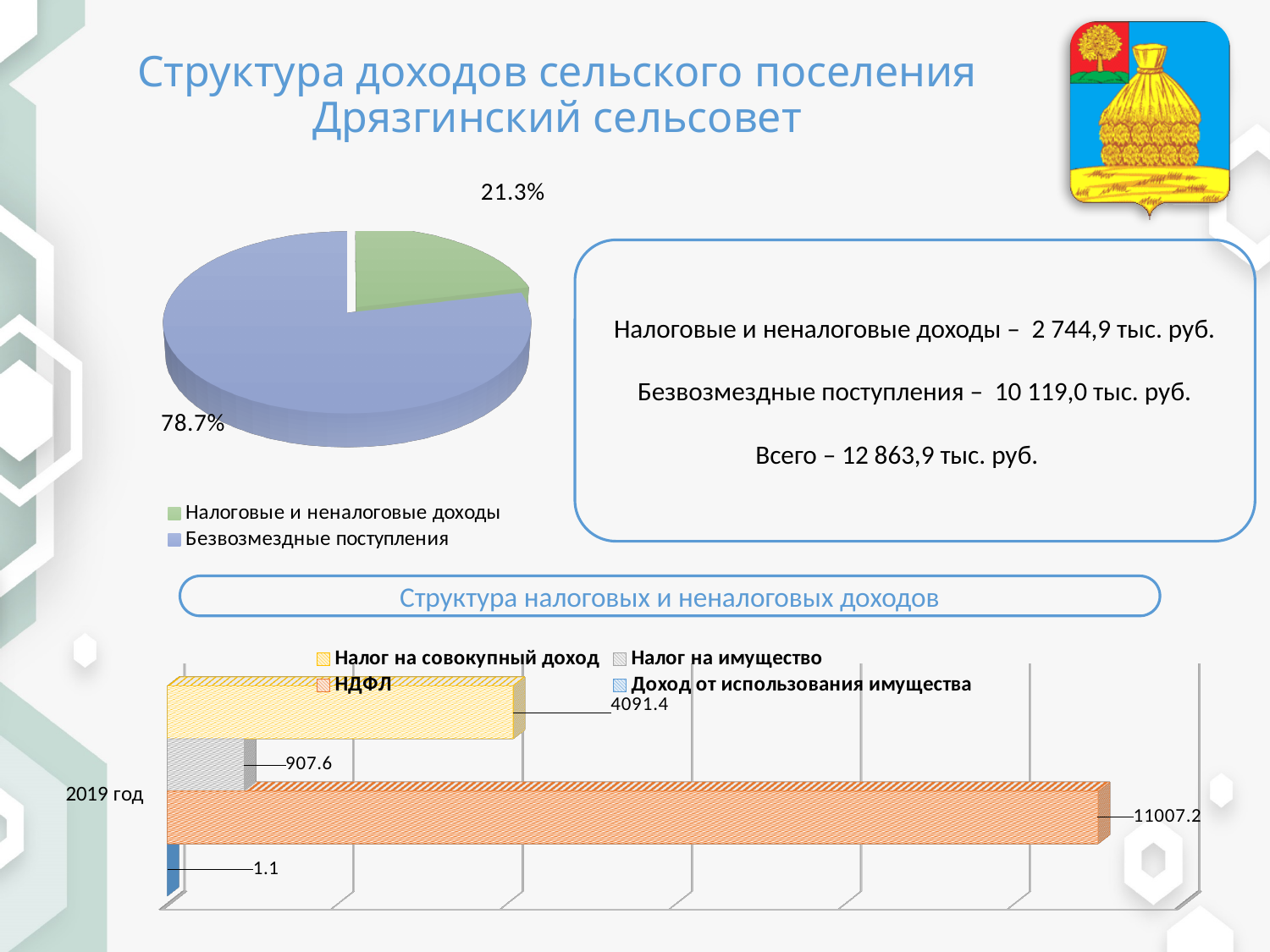
In the bar chart Структура налоговых и неналоговых доходов, how many series does the legend list? 4 What kind of chart is the top-left chart on the slide? pie chart In the bar chart Структура налоговых и неналоговых доходов, what is the value for НДФЛ? 11007.2 In the bar chart Структура налоговых и неналоговых доходов, what is the value for Налог на совокупный доход? 4091.4 In the bar chart Структура налоговых и неналоговых доходов, which series has the lowest value? Доход от использования имущества In the pie chart, what share is shown for Безвозмездные поступления? 78.7% In the bar chart Структура налоговых и неналоговых доходов, what is the difference between НДФЛ and Налог на совокупный доход? 6915.8 In the pie chart, what share is shown for Налоговые и неналоговые доходы? 21.3% In the pie chart, which slice is larger: Налоговые и неналоговые доходы or Безвозмездные поступления? Безвозмездные поступления In the bar chart Структура налоговых и неналоговых доходов, which series has the highest value? НДФЛ In the bar chart Структура налоговых и неналоговых доходов, what is the value for Налог на имущество? 907.6 How many entries does the legend of the pie chart list? 2